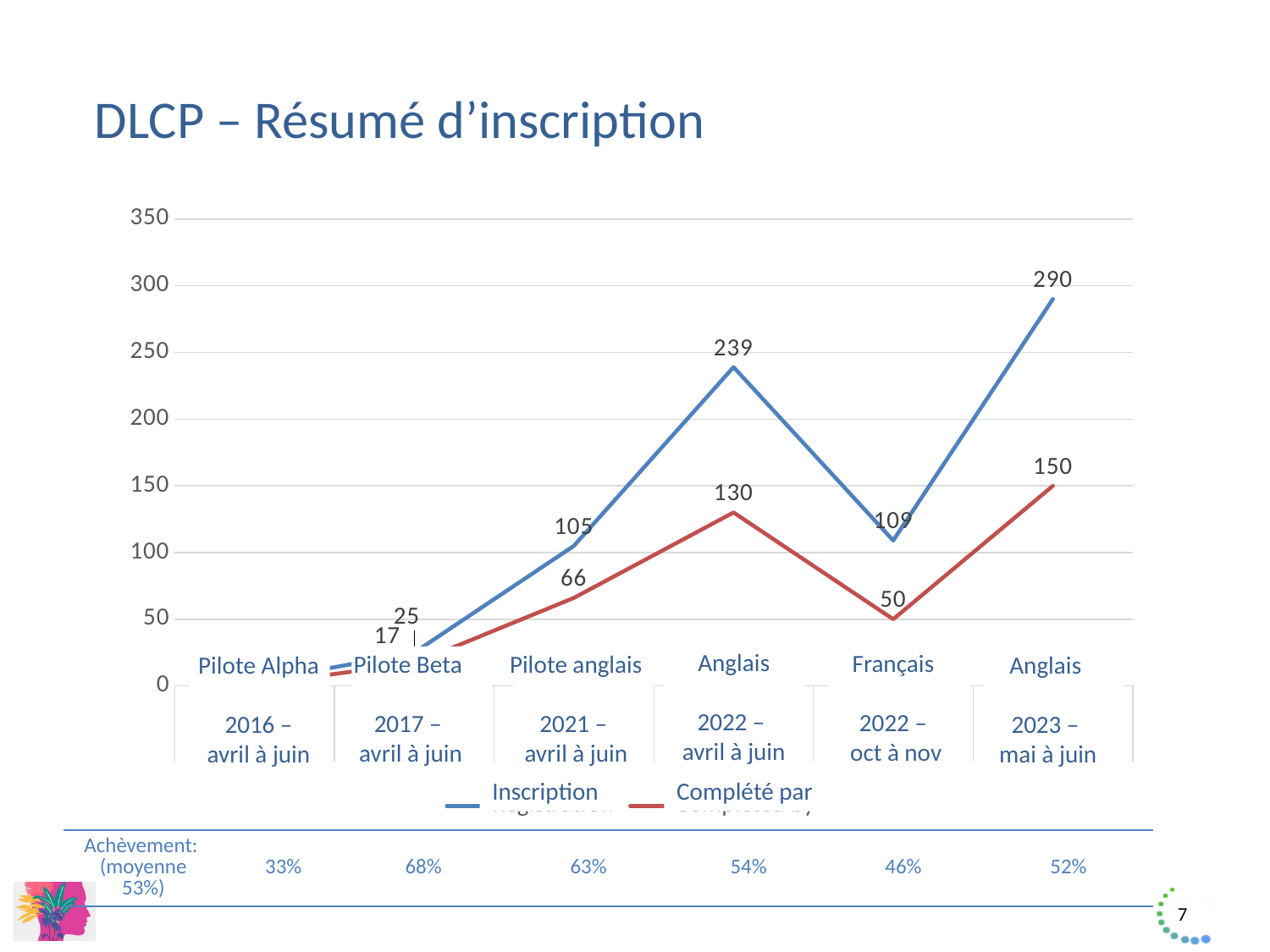
What is the difference between Inscription and Complété par for Anglais (2023 – mai à juin)? 140 What is the Inscription value for Français (2022 – oct à nov)? 109 Which category has the lowest Inscription value? Pilote Alpha What is the Complété par value for Pilote anglais (2021 – avril à juin)? 66 What is the Inscription value for Anglais (2023 – mai à juin)? 290 How many categories are plotted along the x axis? 6 Is the Inscription value for Pilote Alpha greater or less than 50? less What type of chart is shown on the slide? line chart What is the Complété par value for Anglais (2022 – avril à juin)? 130 Does the Inscription line rise or fall from Pilote Beta to Anglais (2022 – avril à juin)? rise Which category has the highest Inscription value? Anglais (2023 – mai à juin) How many series does the legend list? 2